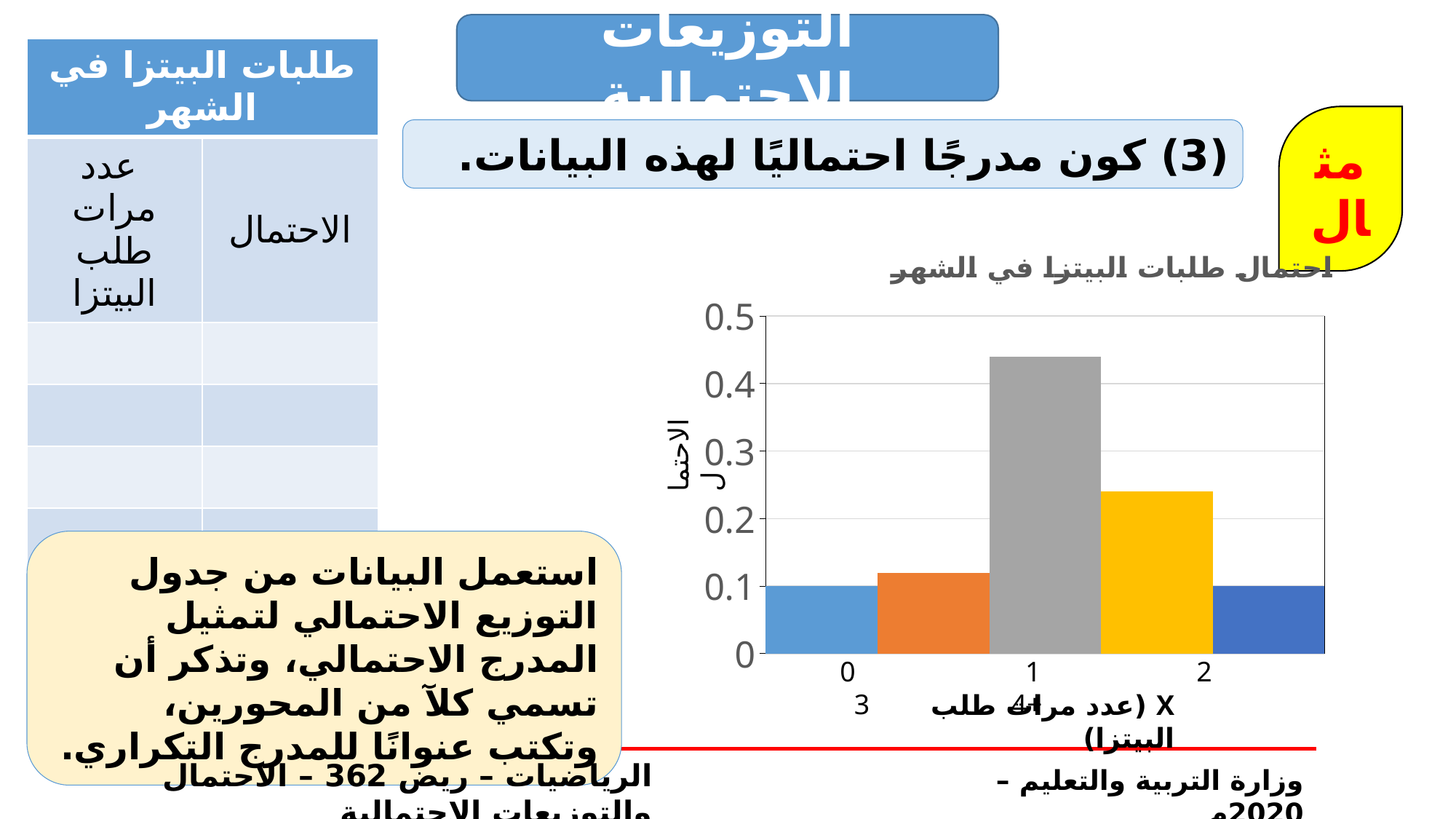
Which is larger, the orange bar or the yellow bar? the yellow bar Is the value of the yellow bar greater or less than 0.2? greater Is the value of the yellow bar greater or less than 0.3? less What is the title of the chart? احتمال طلبات البيتزا في الشهر What value does the first (light blue) bar on the left reach on the y axis? 0.1 What is the title of the y axis of the chart? الاحتمال Which is larger, the gray bar or the yellow bar? the gray bar How many bars are plotted in the chart? 5 Is the value of the gray bar greater or less than 0.4? greater What kind of chart is shown on the slide? bar chart Which bar is the tallest in the chart? the gray bar (third from left)